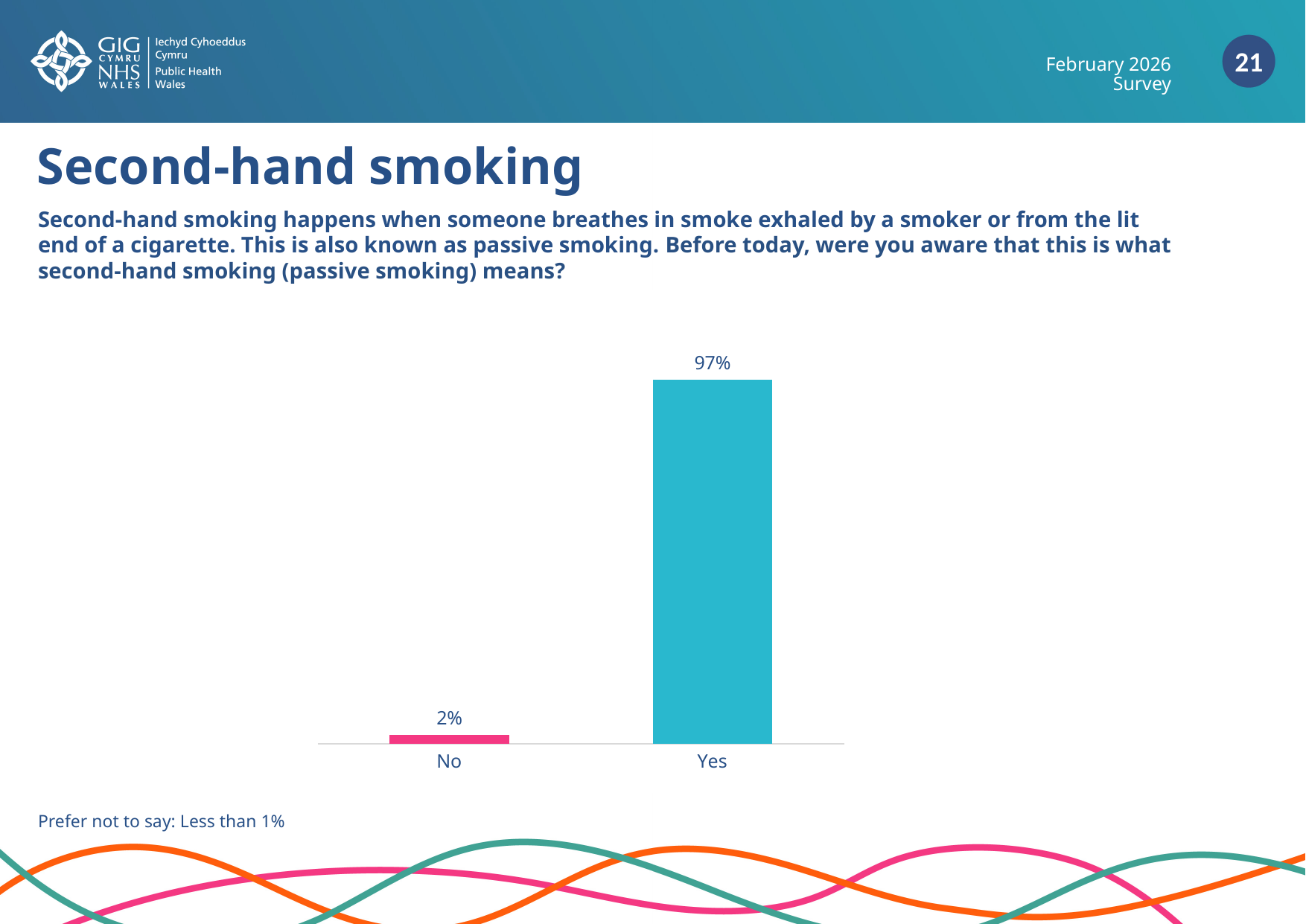
What kind of chart is shown on the slide? Bar chart Which is larger, the value for "No" or the value for "Yes"? Yes According to the note below the chart, what percentage of respondents preferred not to say? Less than 1% Which response category has the lowest value? No What colour is the bar for "Yes"? Blue What percentage of respondents answered "No"? 2% What colour is the bar for "No"? Pink What is the difference in percentage points between the "Yes" and "No" responses? 95 percentage points What percentage of respondents answered "Yes"? 97% Which response category has the highest value? Yes How many response categories are shown in the chart? 2